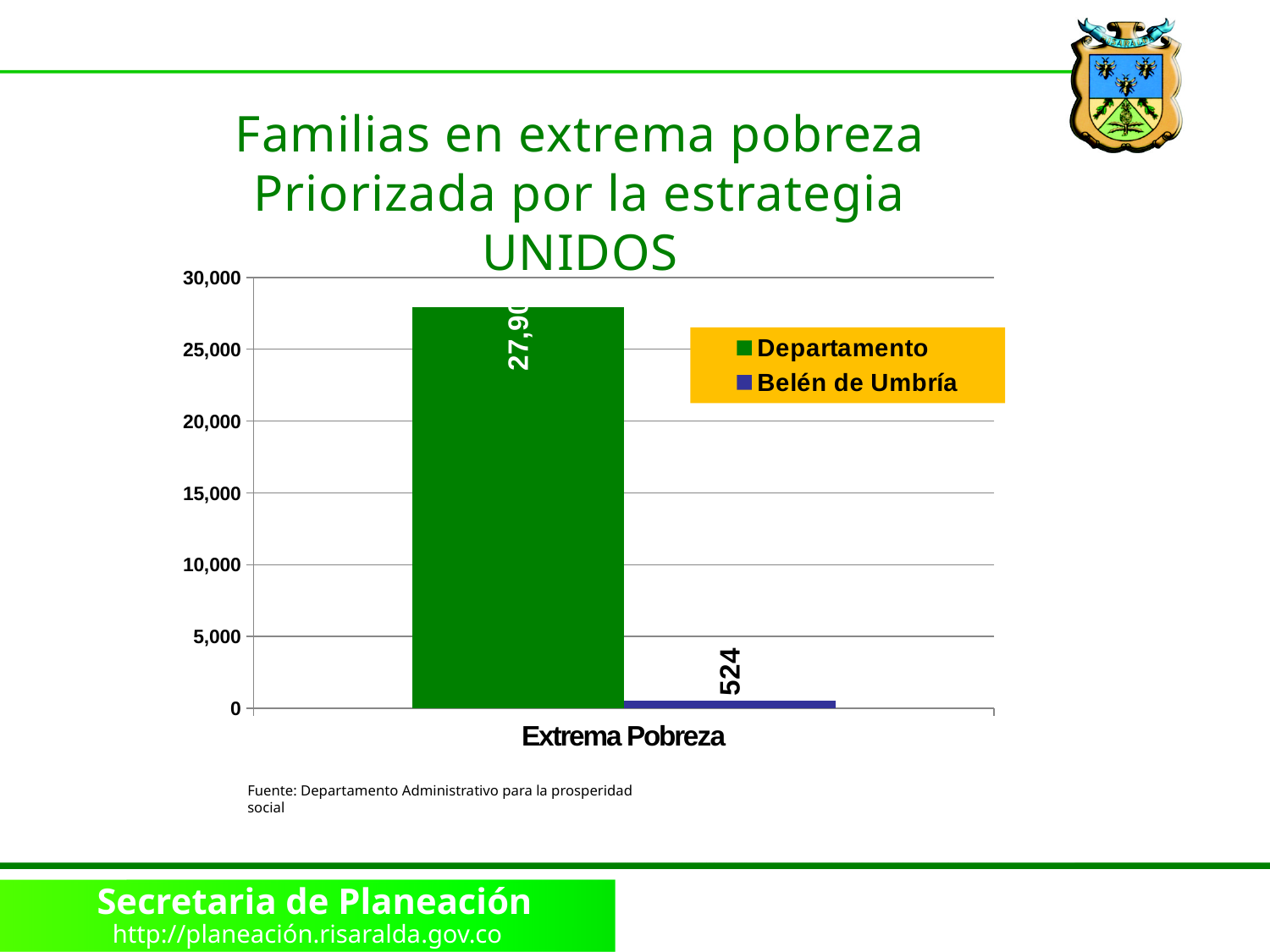
What kind of chart is shown on the slide? bar chart Which is larger, the value for Departamento or the value for Belén de Umbría? Departamento How many categories are shown on the x axis of the chart? 1 Is the value for Departamento greater or less than 25,000? greater Is the value for Departamento greater or less than 30,000? less How many series does the legend list? 2 Is the value for Belén de Umbría greater or less than 5,000? less What colour is the bar for Departamento? green Which series has the lowest value in the chart? Belén de Umbría What is the category label shown on the x axis of the chart? Extrema Pobreza What is the value for Belén de Umbría in the Extrema Pobreza category? 524 Which series has the highest value in the chart? Departamento